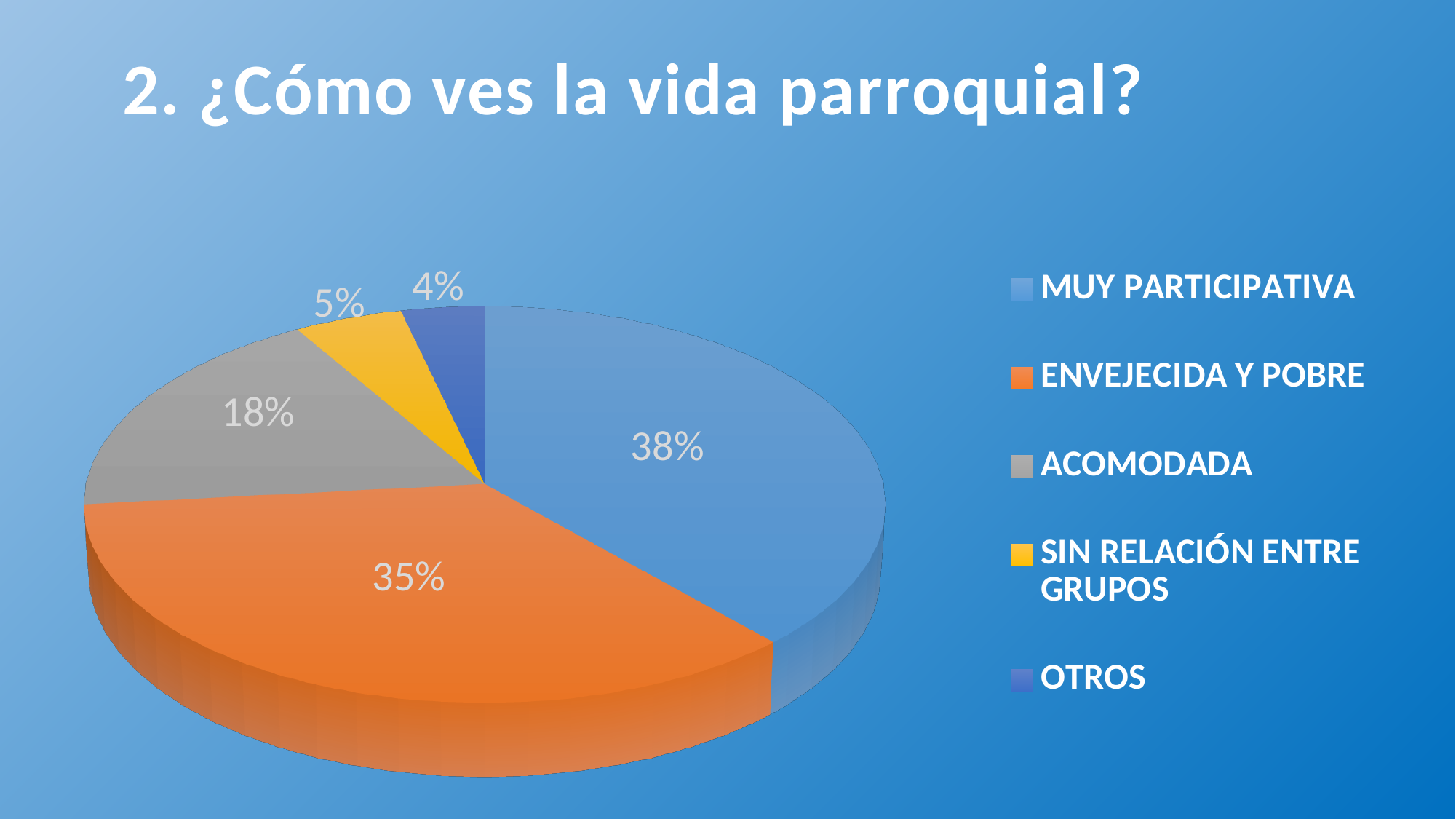
What colour is the slice for ENVEJECIDA Y POBRE? Orange What percentage of the pie chart is labelled MUY PARTICIPATIVA? 38% What kind of chart is shown on the slide? Pie chart What is the difference in percentage points between MUY PARTICIPATIVA and ENVEJECIDA Y POBRE? 3 How many categories does the pie chart show? 5 Which category has the largest slice of the pie chart? MUY PARTICIPATIVA Which is larger, the ACOMODADA slice or the SIN RELACIÓN ENTRE GRUPOS slice? ACOMODADA What percentage of the pie chart is labelled OTROS? 4% What percentage of the pie chart is labelled ACOMODADA? 18% What percentage of the pie chart is labelled ENVEJECIDA Y POBRE? 35% Which category has the smallest slice of the pie chart? OTROS What percentage of the pie chart is labelled SIN RELACIÓN ENTRE GRUPOS? 5%